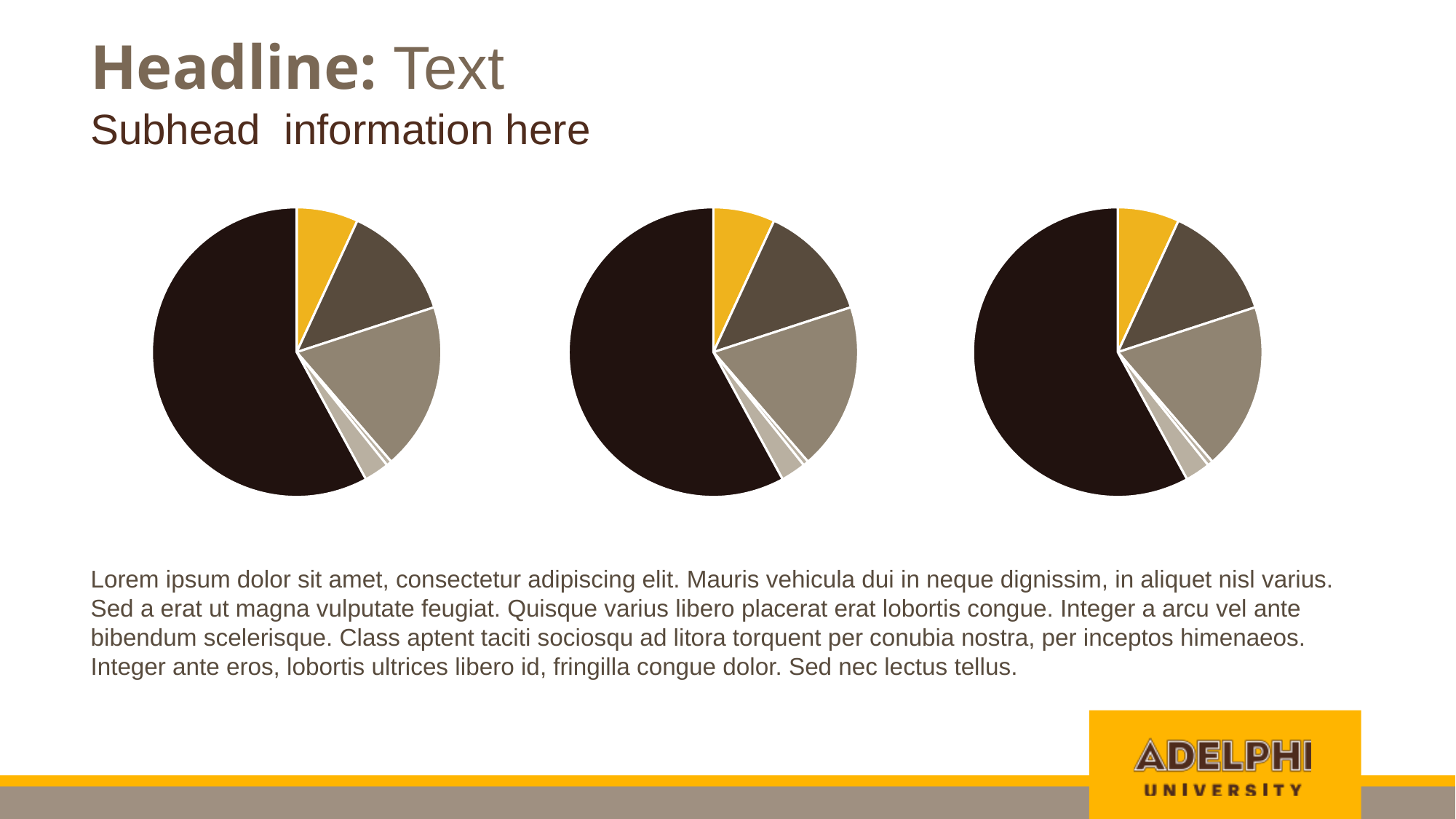
In the right pie chart, is the yellow slice greater or less than half of the pie? less In the left pie chart, is the dark brown slice greater or less than half of the pie? greater What kind of charts are shown on the slide? pie charts In the right pie chart, which colour slice is the largest? dark brown In the middle pie chart, which is larger, the yellow slice or the dark brown slice? the dark brown slice Do the pie charts on the slide have a legend? No In the left pie chart, which colour slice is the largest? dark brown How many pie charts are on the slide? 3 What kind of chart is the left chart on the slide? pie chart In the middle pie chart, which colour slice is the largest? dark brown In the left pie chart, which is larger, the yellow slice or the medium grey-brown slice next to the dark taupe slice? the medium grey-brown slice